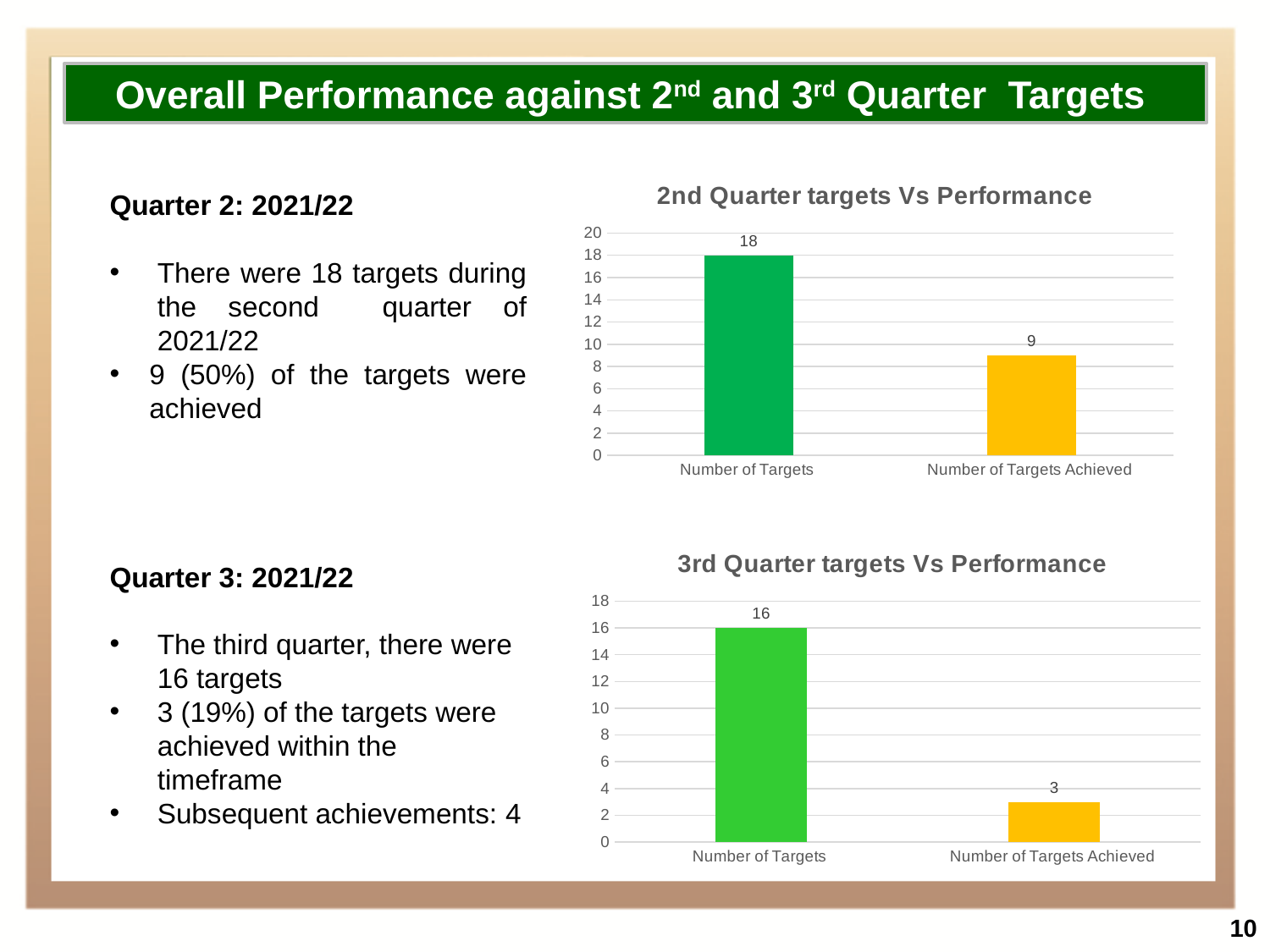
In the '3rd Quarter targets Vs Performance' chart, what is the value for Number of Targets? 16 In the '2nd Quarter targets Vs Performance' chart, is the value for Number of Targets Achieved greater or less than 10? less What is the title of the bottom chart on the slide? 3rd Quarter targets Vs Performance In the '3rd Quarter targets Vs Performance' chart, which category has the lowest value? Number of Targets Achieved In the '2nd Quarter targets Vs Performance' chart, what is the difference between Number of Targets and Number of Targets Achieved? 9 In the '3rd Quarter targets Vs Performance' chart, what is the value for Number of Targets Achieved? 3 In the '2nd Quarter targets Vs Performance' chart, which category has the highest value? Number of Targets What kind of chart is the '2nd Quarter targets Vs Performance' chart? bar chart In the '3rd Quarter targets Vs Performance' chart, what is the difference between Number of Targets and Number of Targets Achieved? 13 In the '2nd Quarter targets Vs Performance' chart, what is the value for Number of Targets? 18 How many categories are shown in the '3rd Quarter targets Vs Performance' chart? 2 In the '2nd Quarter targets Vs Performance' chart, what is the value for Number of Targets Achieved? 9